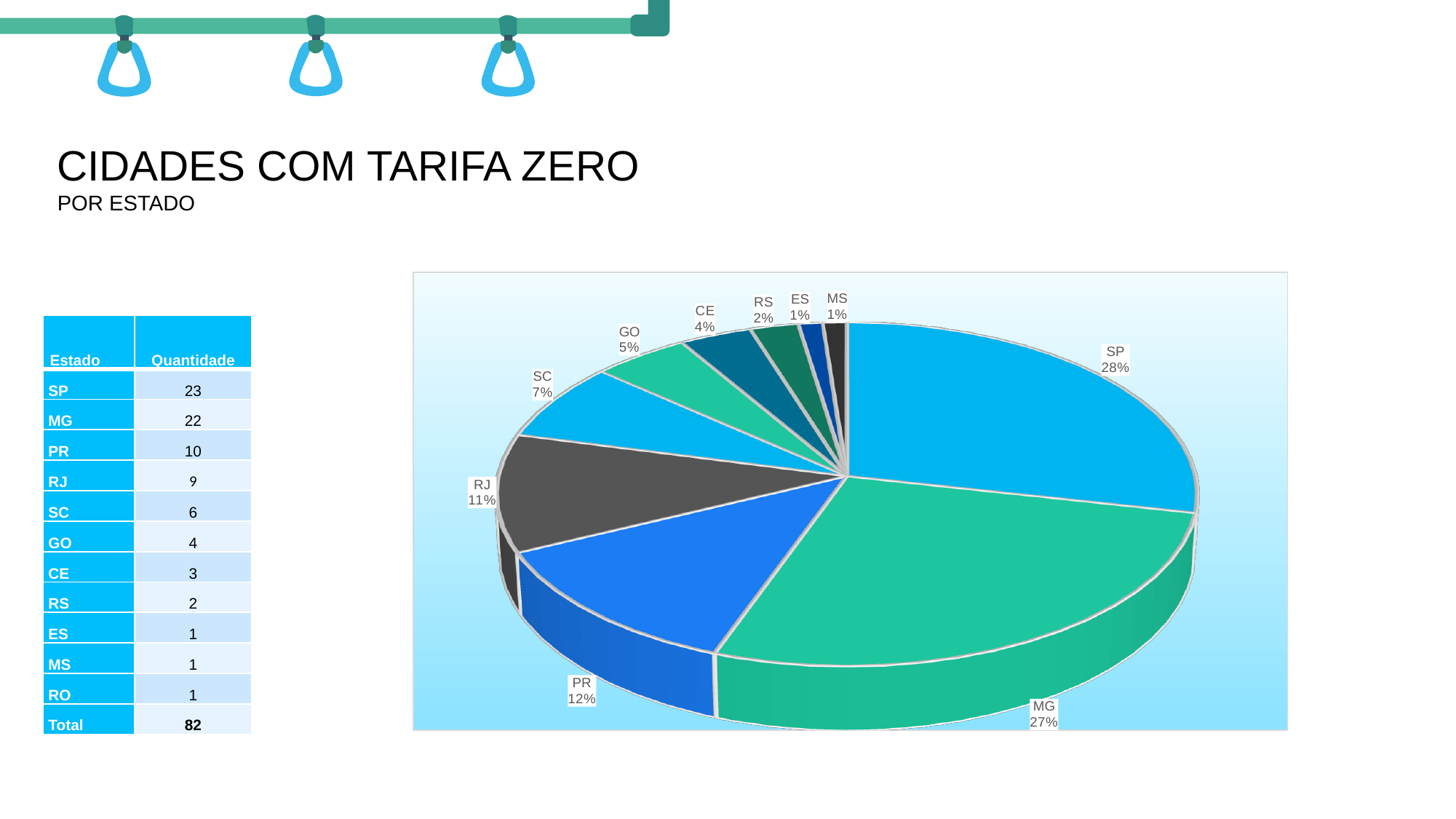
What percentage is shown for RJ in the pie chart? 11% What percentage is shown for GO in the pie chart? 5% What percentage is shown for CE in the pie chart? 4% What is the difference in percentage points between the SC slice and the RS slice? 5 What percentage is shown for SC in the pie chart? 7% What is the difference in percentage points between the SP slice and the MG slice? 1 What kind of chart is shown on the slide? pie chart What share of the pie does SP have? 28% What share of the pie does MG have? 27% What percentage is shown for PR in the pie chart? 12% Which state has the largest slice of the pie chart? SP Which slice is larger in the pie chart, PR or RJ? PR